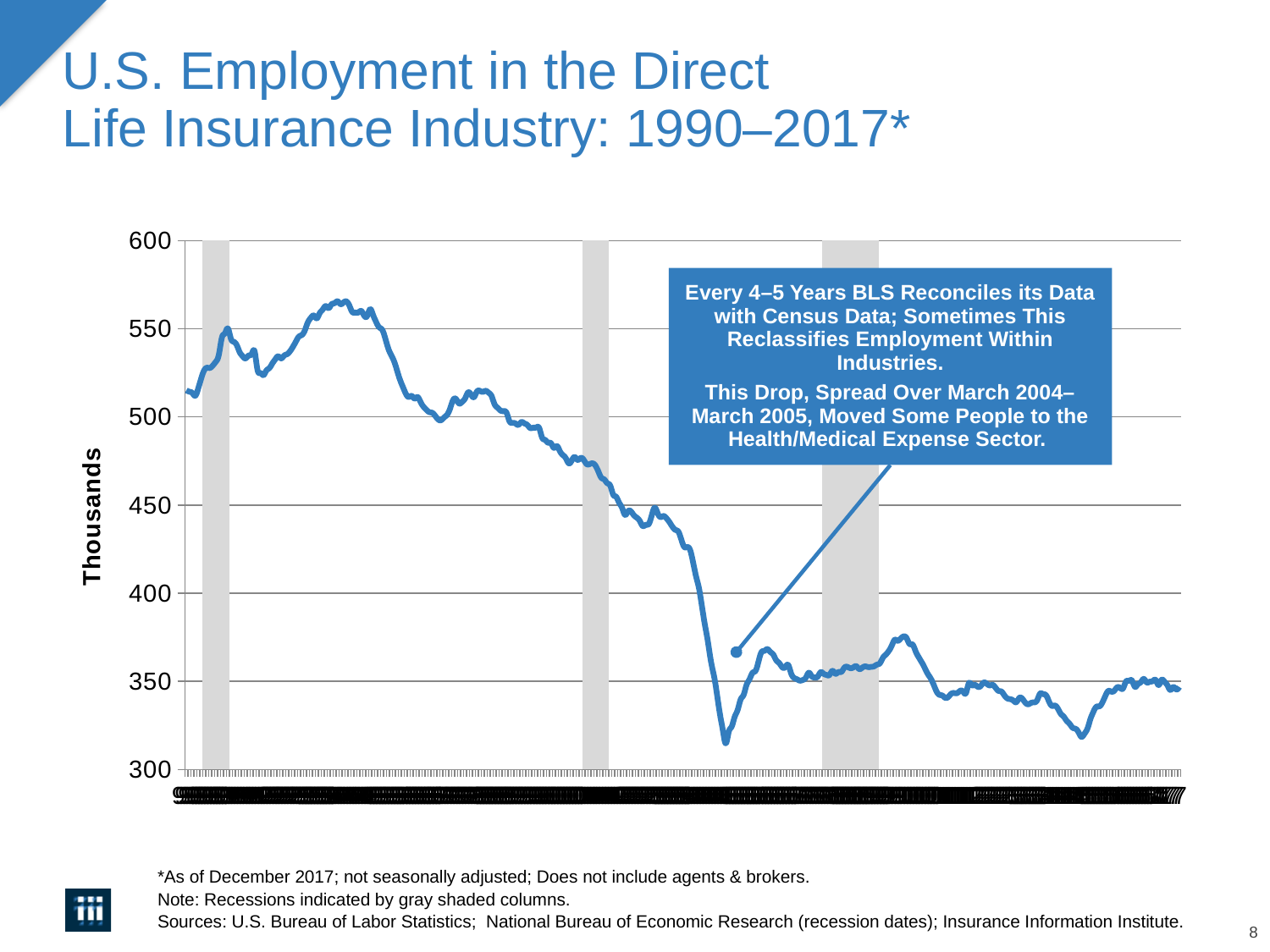
Is the lowest point of the line greater or less than 350? less Which is larger, the value at the left end of the line or the value at the right end of the line? the left end What is the lowest value shown on the vertical axis? 300 Is the highest point of the line greater or less than 550? greater What kind of chart is shown on the slide? line chart Is the value at the start of the line (left end) greater or less than 500? greater What is the label on the vertical axis? Thousands Overall, do the values rise or fall from the left end of the chart to the right end? fall What is the title of the chart? U.S. Employment in the Direct Life Insurance Industry: 1990–2017*